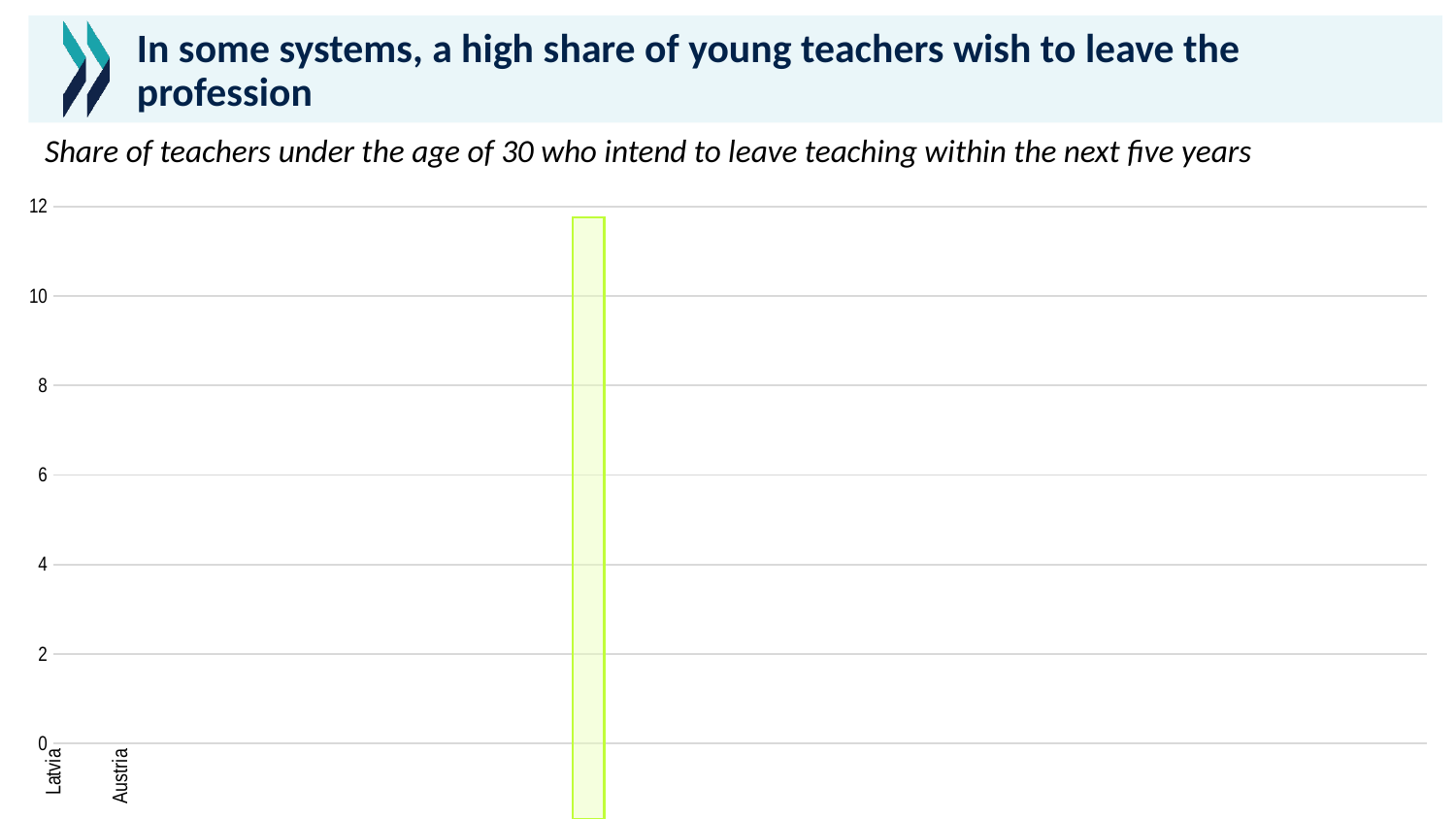
What is the subtitle describing the data plotted in the chart? Share of teachers under the age of 30 who intend to leave teaching within the next five years What is the highest value shown on the chart's vertical axis? 12 What kind of chart is shown on the slide? bar chart Is the value of the single visible bar in the chart greater or less than 10? greater